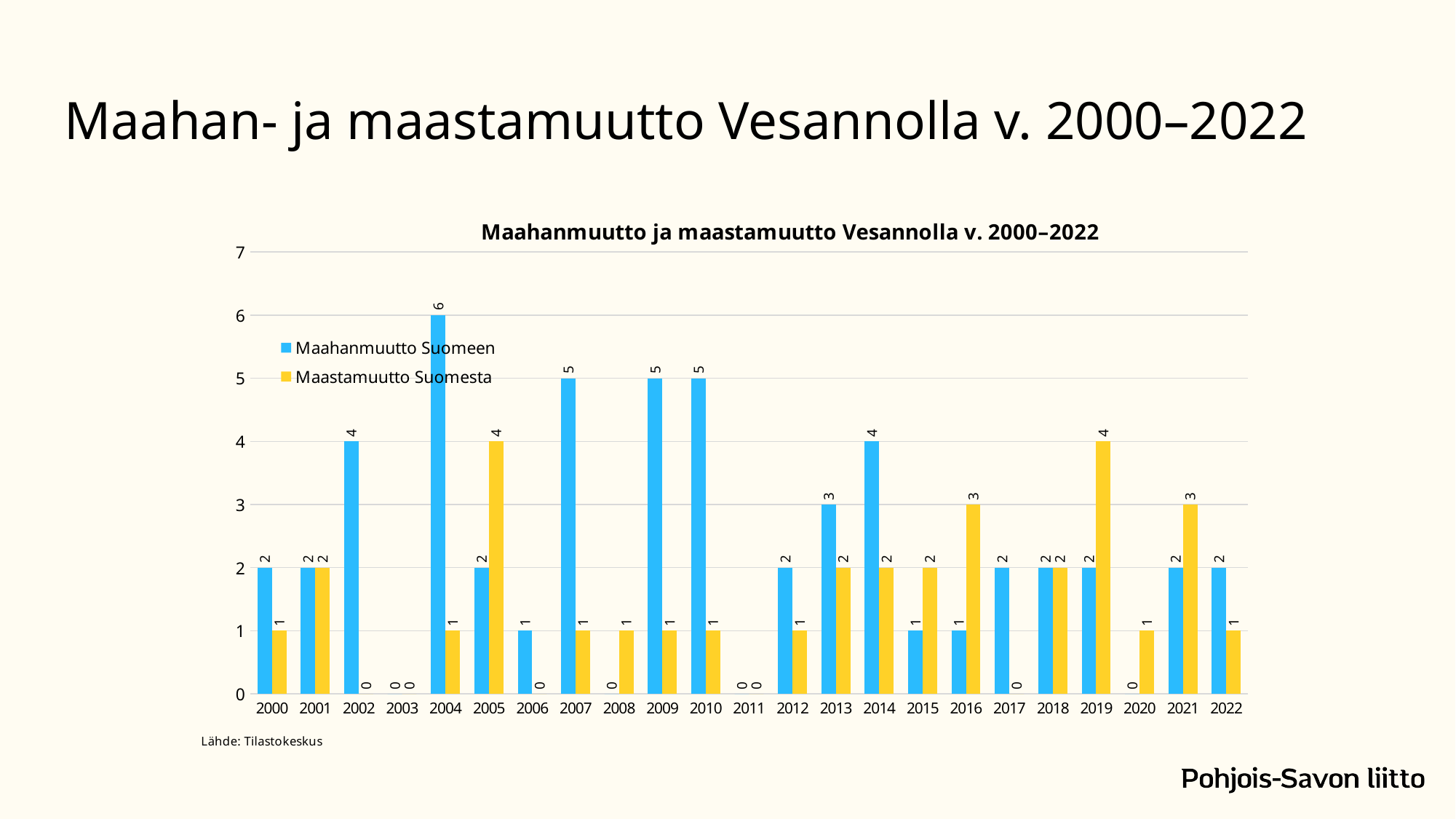
Which is larger in 2007, Maahanmuutto Suomeen or Maastamuutto Suomesta? Maahanmuutto Suomeen How many years are shown on the x axis of the chart? 23 What is the difference between Maastamuutto Suomesta in 2019 and Maahanmuutto Suomeen in 2019? 2 What is the value of Maastamuutto Suomesta in 2016? 3 How many series does the legend list? 2 What is the value of Maahanmuutto Suomeen in 2004? 6 In which year is Maahanmuutto Suomeen highest? 2004 Which is larger in 2021, Maahanmuutto Suomeen or Maastamuutto Suomesta? Maastamuutto Suomesta What is the value of Maastamuutto Suomesta in 2005? 4 What is the difference between Maahanmuutto Suomeen and Maastamuutto Suomesta in 2014? 2 What kind of chart is shown on the slide? Bar chart What is the title of the chart? Maahanmuutto ja maastamuutto Vesannolla v. 2000–2022